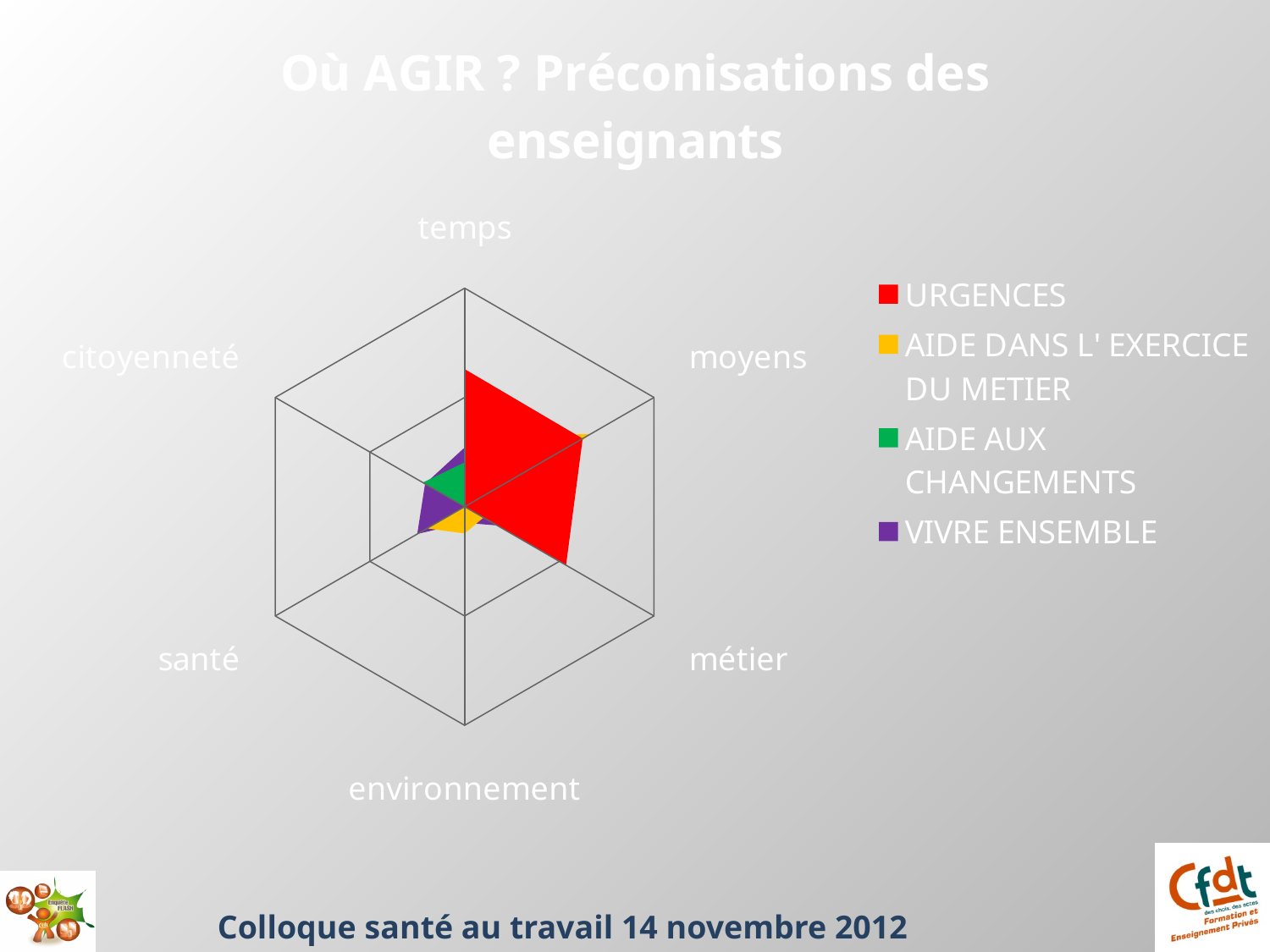
Which series covers the largest area on the radar chart? URGENCES Which series has the larger value for métier, URGENCES or AIDE AUX CHANGEMENTS? URGENCES What kind of chart is shown on the slide? Radar chart What is the title of the slide containing the chart? Où AGIR ? Préconisations des enseignants How many categories (axes) does the radar chart have? 6 Which series has the larger value for moyens, URGENCES or VIVRE ENSEMBLE? URGENCES Which series is shown in red in the legend? URGENCES Which series has the larger value for temps, URGENCES or AIDE DANS L' EXERCICE DU METIER? URGENCES How many series does the legend list? 4